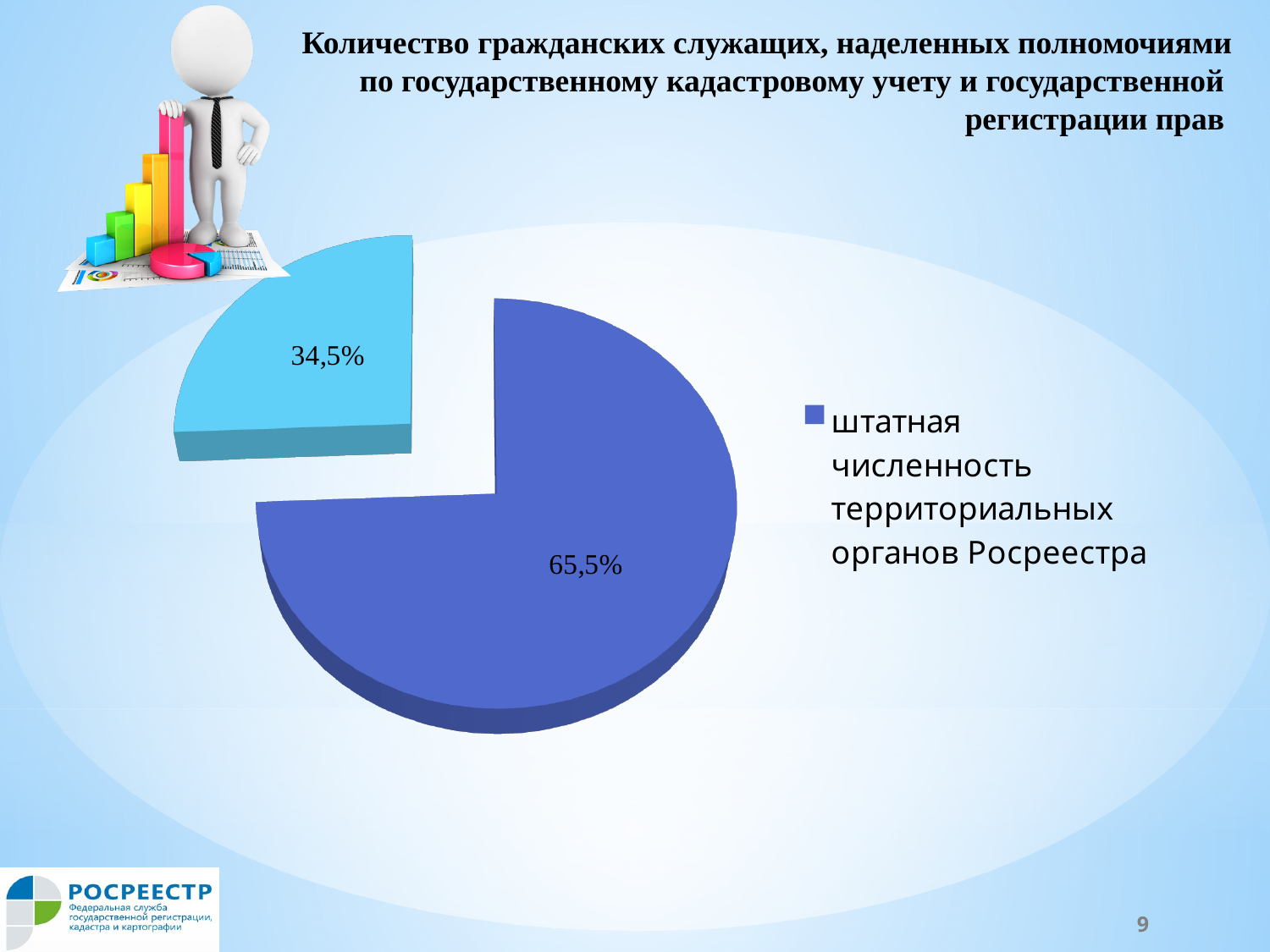
Which slice is larger, the dark blue one or the light blue one? the dark blue one What kind of chart is shown on the slide? pie chart What is the largest value shown in the pie chart? 65,5% What percentage is shown on the smaller, light blue slice of the pie chart? 34,5% What is the legend entry shown next to the pie chart? штатная численность территориальных органов Росреестра How many entries does the legend of the pie chart list? 1 What value is shown on the slice whose colour matches the legend entry 'штатная численность территориальных органов Росреестра'? 65,5% What is the difference between the two slices of the pie chart? 31% What percentage is shown on the larger, dark blue slice of the pie chart? 65,5% Is the value of the light blue slice greater or less than 50%? less What is the smallest value shown in the pie chart? 34,5% How many slices does the pie chart have? 2